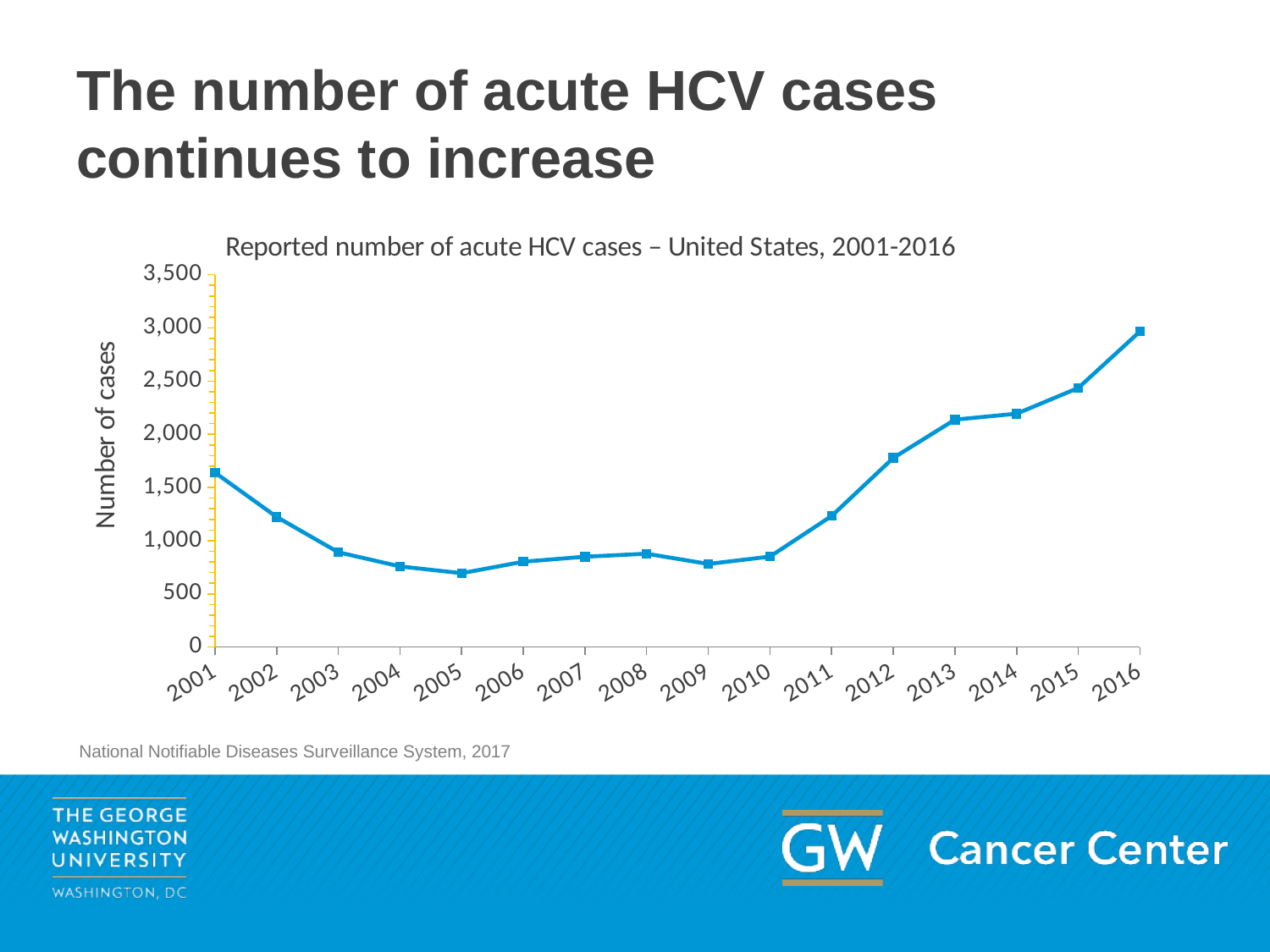
Which year has more reported acute HCV cases, 2001 or 2011? 2001 Is the value for 2016 greater or less than 2,500? greater Is the value for 2001 greater or less than 1,500? greater Do the values rise or fall from 2010 to 2016? rise What is the label on the vertical axis of the chart? Number of cases Is the value for 2013 greater or less than 2,000? greater What is the title of the chart? Reported number of acute HCV cases – United States, 2001-2016 How many years are plotted on the x axis of the chart? 16 Which year has the highest number of reported acute HCV cases? 2016 What kind of chart is shown on the slide? line chart Which year has the lowest number of reported acute HCV cases? 2005